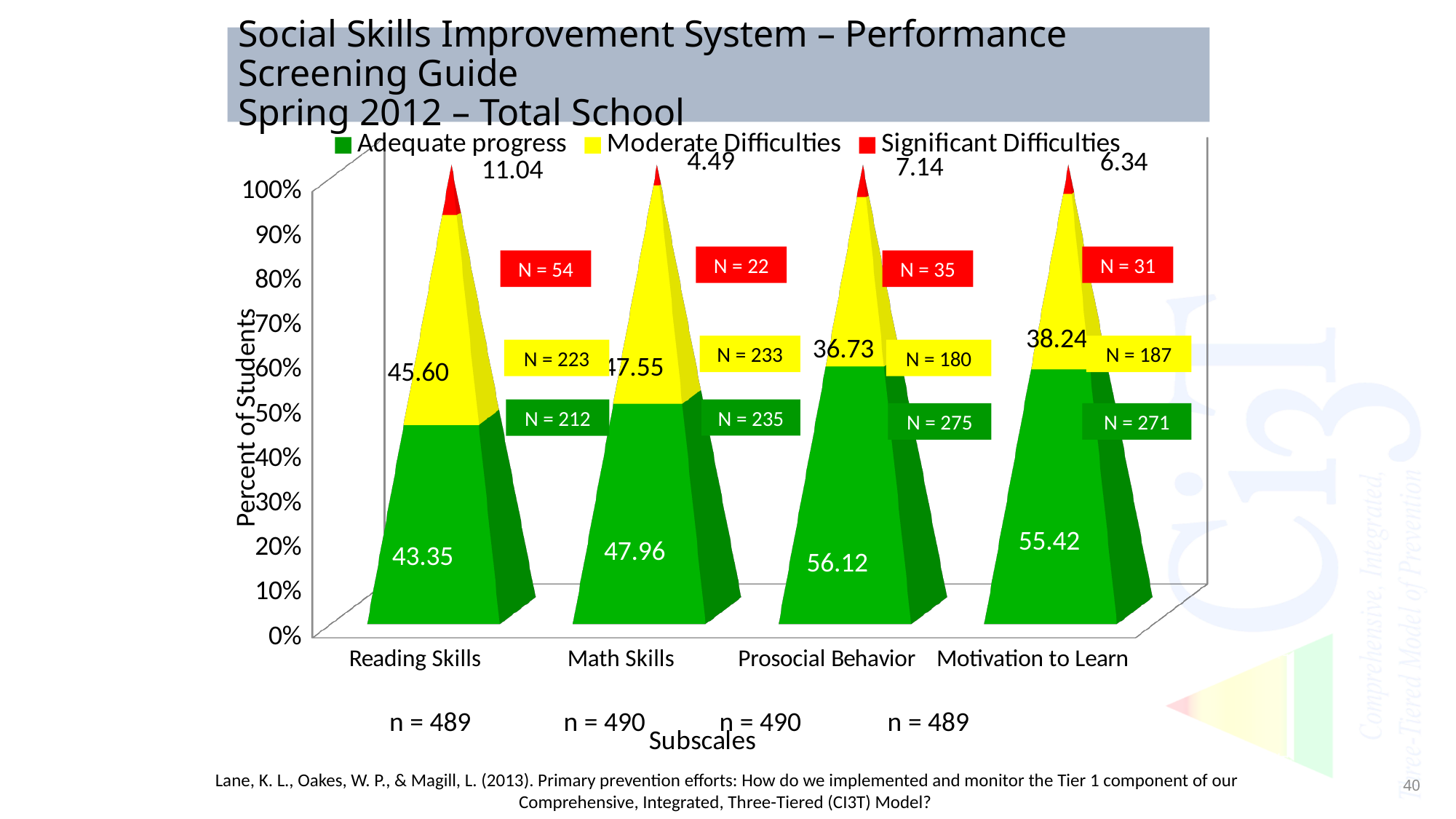
How many series does the legend list? 3 How many subscales are shown on the x axis? 4 What is the Moderate Difficulties value for Prosocial Behavior? 36.73 Which is larger, the Moderate Difficulties value for Reading Skills or for Motivation to Learn? Reading Skills What is the Significant Difficulties value for Math Skills? 4.49 What is the difference between the Significant Difficulties values for Reading Skills and Math Skills? 6.55 Which subscale has the highest Significant Difficulties value? Reading Skills What is the Adequate progress value for Reading Skills? 43.35 What is the Adequate progress value for Motivation to Learn? 55.42 What is the label on the y axis? Percent of Students What kind of chart is shown? Stacked bar chart Which subscale has the lowest Adequate progress value? Reading Skills